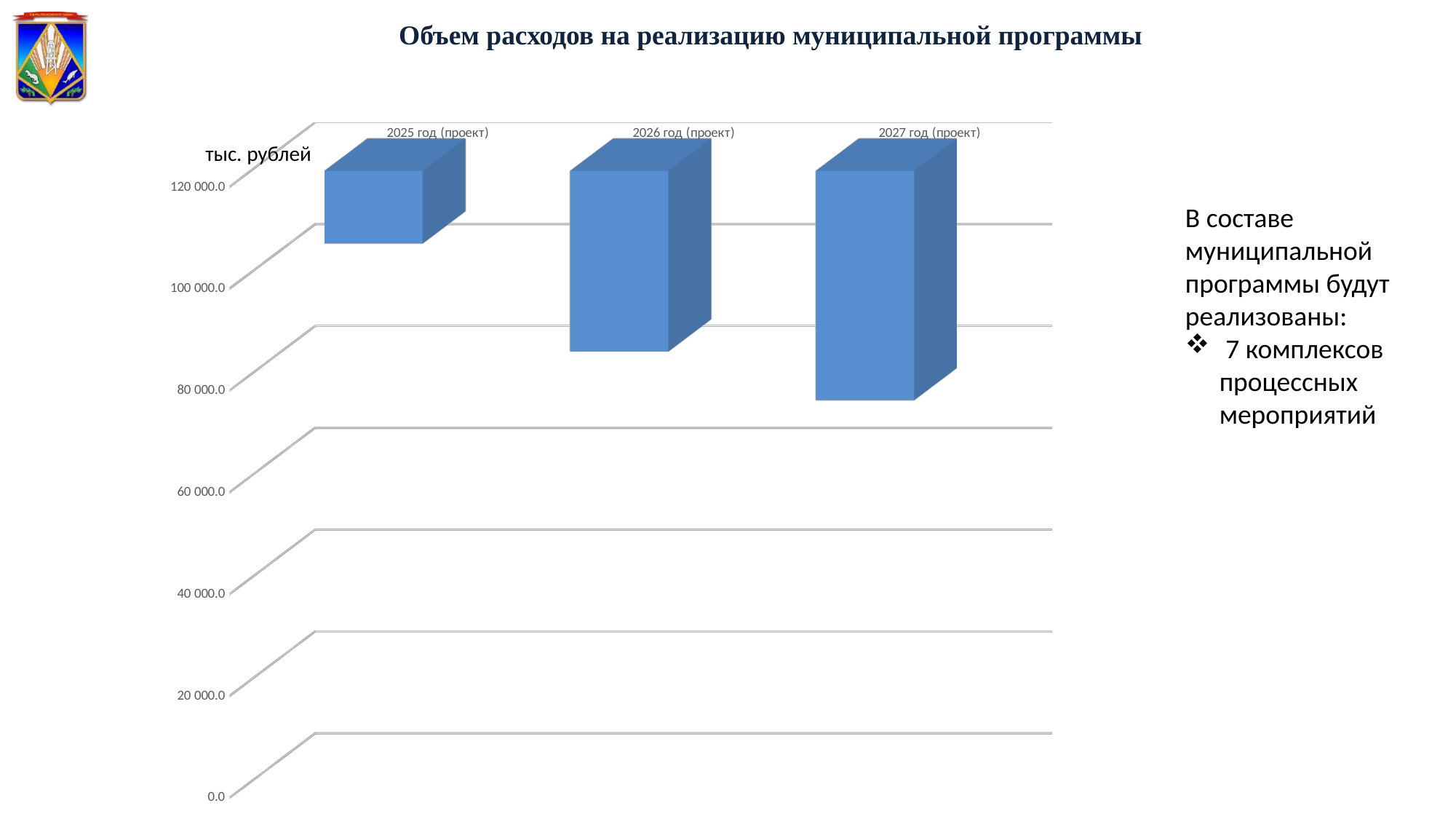
What kind of chart is shown on the slide? bar chart What is the label of the first category on the chart? 2025 год (проект) How many bars (categories) does the chart show? 3 What is the title of the chart on the slide? Объем расходов на реализацию муниципальной программы What is the highest value labelled on the vertical axis of the chart? 120 000.0 What unit is indicated for the values on the chart? тыс. рублей